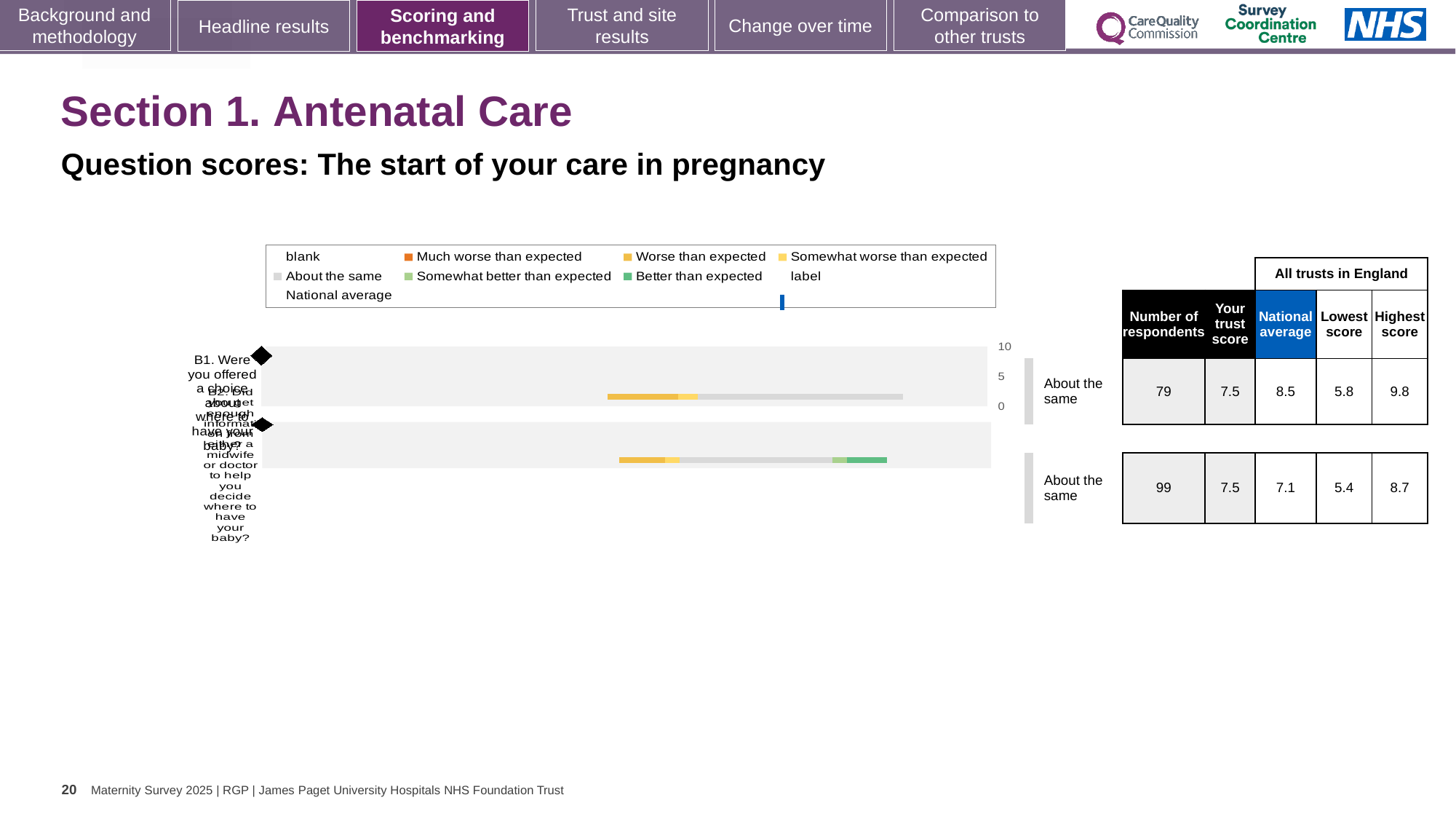
How many questions (bars) are plotted in the chart? 2 How many respondents answered question B2? 99 What is the trust score for question B1 (Were you offered a choice about where to have your baby?)? 7.5 Which question has the higher 'Highest score' value? B1 What colour does the legend use for 'Better than expected'? green Which question has the higher national average, B1 or B2? B1 For question B2, which is larger: the trust score or the national average? the trust score What is the difference between the highest score and the lowest score for question B1? 4.0 What benchmark category is shown for question B1? About the same What is the national average for question B1? 8.5 What is the subtitle describing the chart's content? Question scores: The start of your care in pregnancy What kind of chart is shown on the slide? bar chart